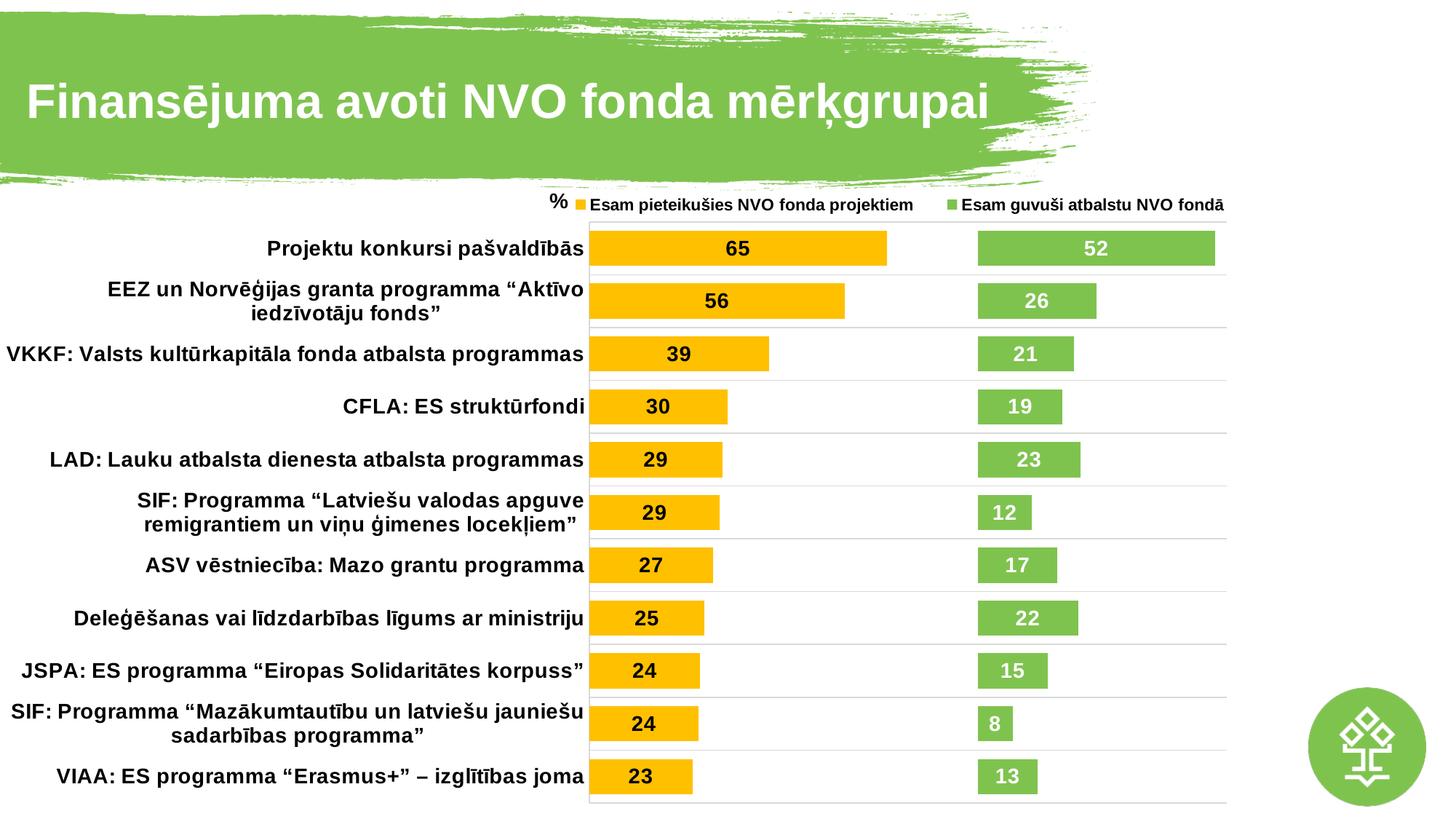
What kind of chart is shown on the slide? Bar chart What colour are the bars for the "Esam guvuši atbalstu NVO fondā" series? Green Which category has the lowest value in the "Esam pieteikušies NVO fonda projektiem" series? VIAA: ES programma "Erasmus+" – izglītības joma Which is larger for "Deleģēšanas vai līdzdarbības līgums ar ministriju": the "Esam pieteikušies NVO fonda projektiem" value or the "Esam guvuši atbalstu NVO fondā" value? Esam pieteikušies NVO fonda projektiem How many categories are shown in the chart? 11 Which category has the lowest value in the "Esam guvuši atbalstu NVO fondā" series? SIF: Programma "Mazākumtautību un latviešu jauniešu sadarbības programma" What is the difference between the two series for "EEZ un Norvēģijas granta programma "Aktīvo iedzīvotāju fonds""? 30 Which category has the highest value in the "Esam guvuši atbalstu NVO fondā" series? Projektu konkursi pašvaldībās How many series does the legend list? 2 What is the value for "CFLA: ES struktūrfondi" in the "Esam guvuši atbalstu NVO fondā" series? 19 What is the value for "VKKF: Valsts kultūrkapitāla fonda atbalsta programmas" in the "Esam pieteikušies NVO fonda projektiem" series? 39 What is the value for "Projektu konkursi pašvaldībās" in the "Esam pieteikušies NVO fonda projektiem" series? 65